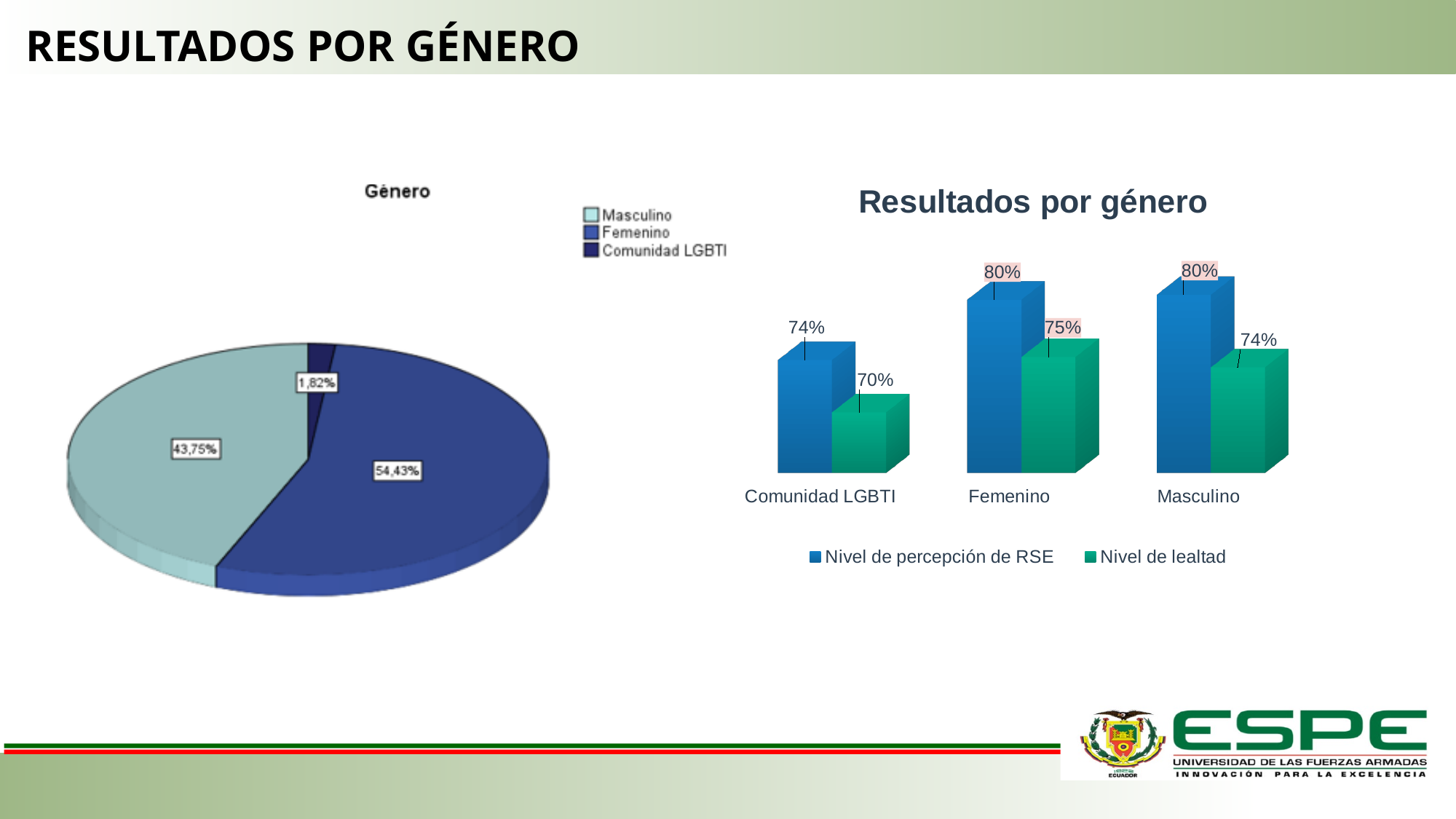
In the chart titled "Resultados por género", what is the Nivel de lealtad value for Comunidad LGBTI? 70% What kind of chart is the chart titled "Resultados por género"? Bar chart In the pie chart titled "Género", what percentage is shown for Femenino? 54,43% In the pie chart titled "Género", what percentage is shown for Masculino? 43,75% In the chart titled "Resultados por género", what is the difference between Nivel de percepción de RSE and Nivel de lealtad for Femenino? 5% In the chart titled "Resultados por género", what is the Nivel de lealtad value for Masculino? 74% In the chart titled "Resultados por género", which category has the lowest Nivel de lealtad? Comunidad LGBTI In the chart titled "Resultados por género", how many series does the legend list? 2 In the pie chart titled "Género", which category has the smallest slice? Comunidad LGBTI In the pie chart titled "Género", how many categories does the legend list? 3 In the pie chart titled "Género", which category has the largest slice? Femenino In the chart titled "Resultados por género", what is the Nivel de percepción de RSE value for Femenino? 80%